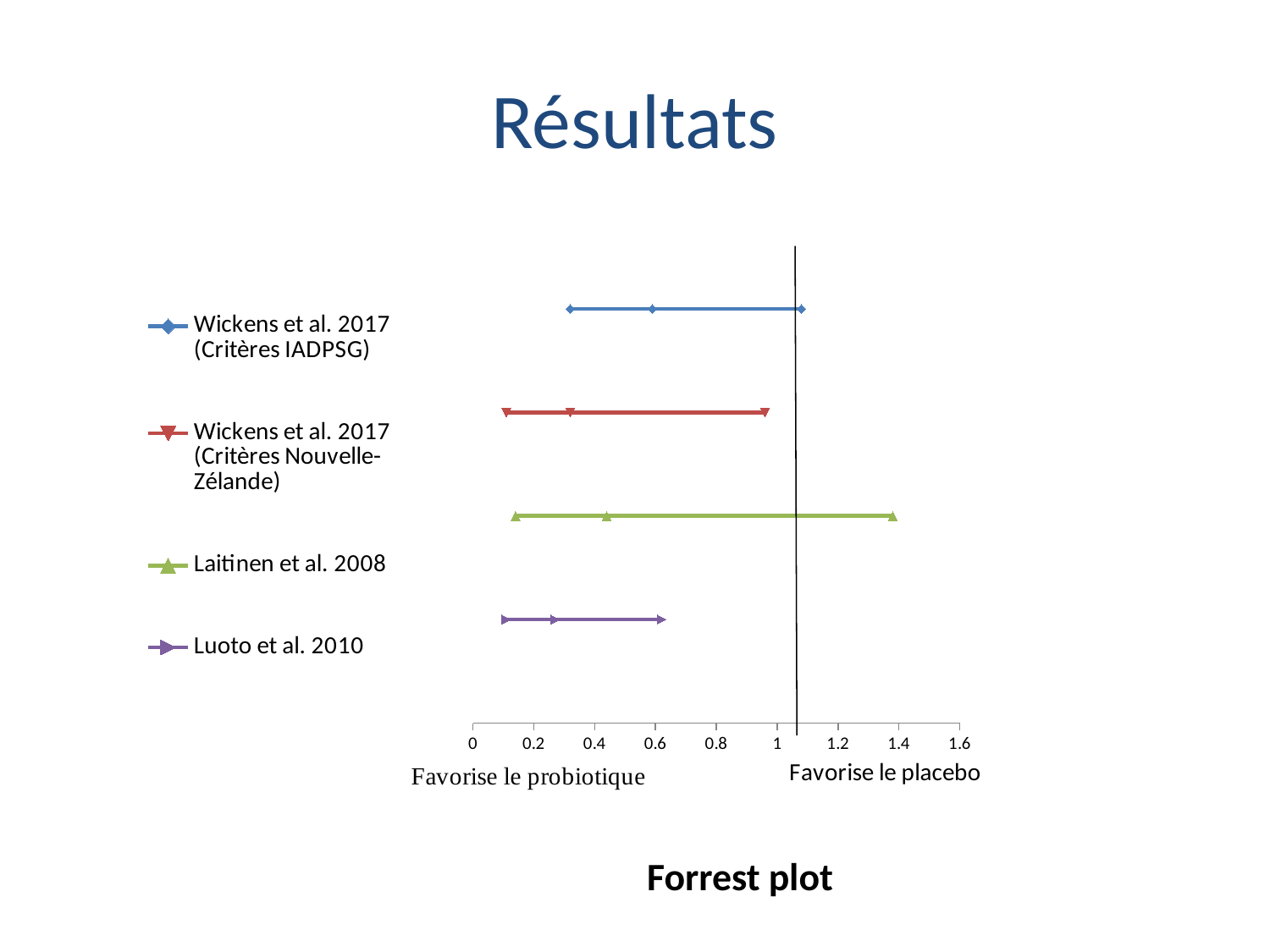
Which study has the highest central point estimate? Wickens et al. 2017 (Critères IADPSG) How many series does the legend list? 4 Is the upper end of the interval for Laitinen et al. 2008 greater or less than 1.2? greater Is the central point estimate for Luoto et al. 2010 greater or less than 0.4? less Which study's interval has the lowest upper end on the x axis? Luoto et al. 2010 What label appears under the left side of the x axis? Favorise le probiotique Is the central point estimate for Wickens et al. 2017 (Critères IADPSG) greater or less than 0.4? greater What is the highest tick value shown on the x axis? 1.6 Which study's interval reaches the highest value on the x axis? Laitinen et al. 2008 Which study has the widest interval (longest horizontal line)? Laitinen et al. 2008 What kind of chart is shown on the slide? Forest plot (line chart with markers)